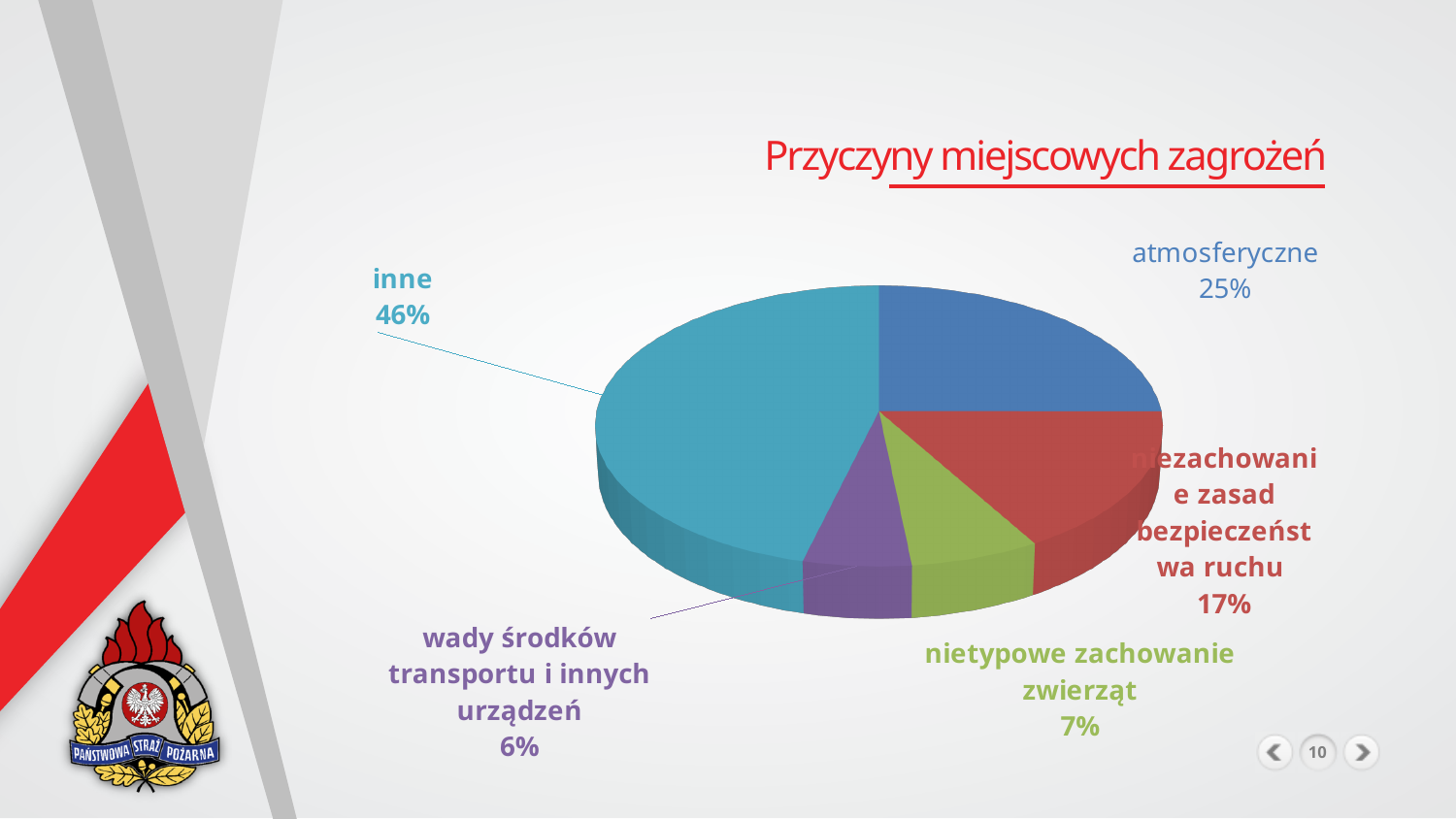
What is the title of the chart? Przyczyny miejscowych zagrożeń What share of the pie is labelled "wady środków transportu i innych urządzeń"? 6% What share of the pie is labelled "niezachowanie zasad bezpieczeństwa ruchu"? 17% What is the difference in percentage points between "inne" and "atmosferyczne"? 21 What share of the pie is labelled "inne"? 46% Which category has the largest slice of the pie? inne What type of chart is shown on the slide? pie chart How many slices does the pie chart have? 5 Which is larger, the slice for "atmosferyczne" or the slice for "niezachowanie zasad bezpieczeństwa ruchu"? atmosferyczne What share of the pie is labelled "atmosferyczne"? 25% Which category has the smallest slice of the pie? wady środków transportu i innych urządzeń What share of the pie is labelled "nietypowe zachowanie zwierząt"? 7%